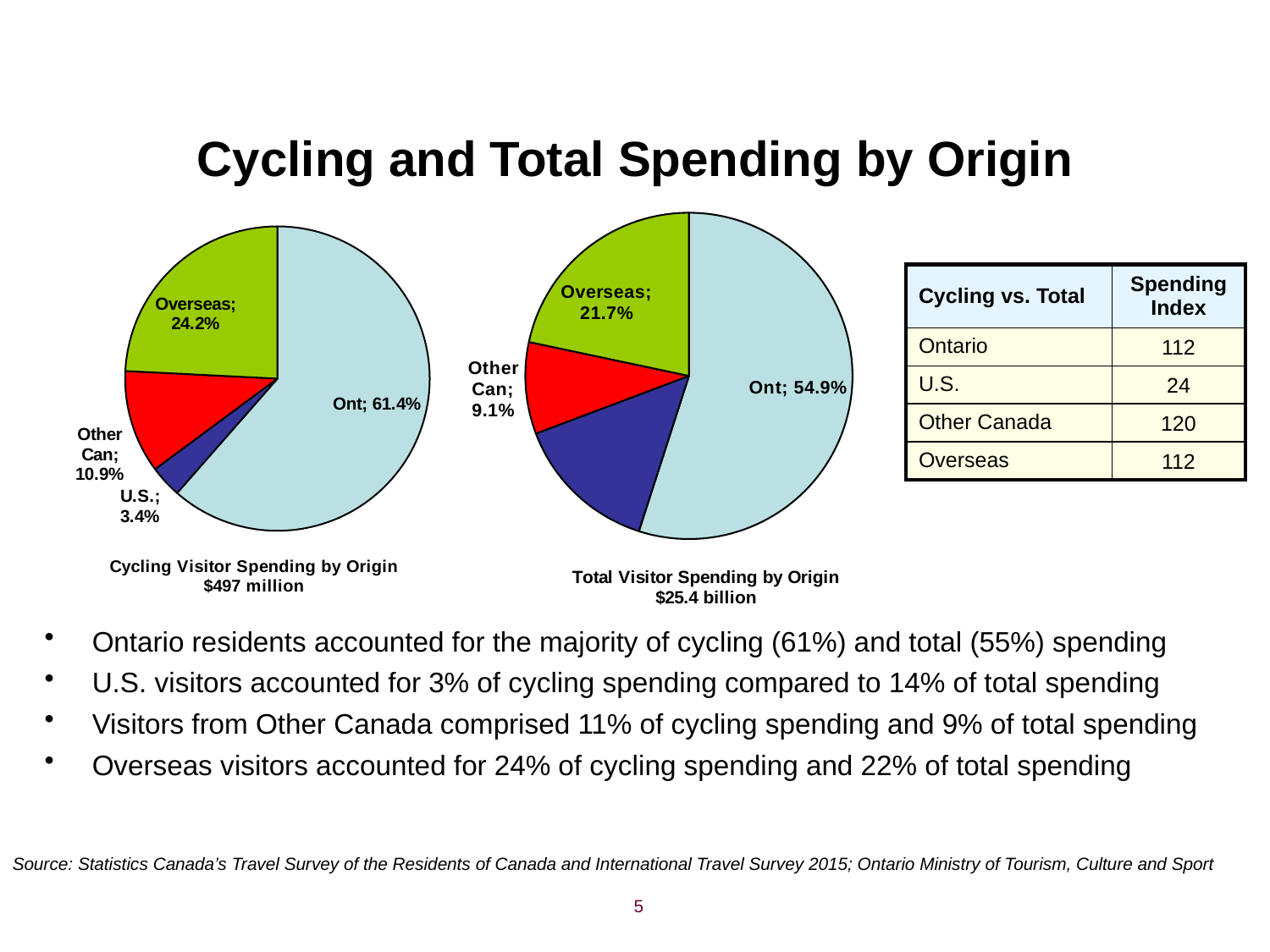
In the Total Visitor Spending by Origin pie chart, what share does Ontario account for? 54.9% In the Cycling Visitor Spending by Origin pie chart, what share does the U.S. account for? 3.4% What type of chart is used for Total Visitor Spending by Origin? Pie chart In the Cycling Visitor Spending by Origin pie chart, what share does Overseas account for? 24.2% Is the Ontario share larger in the Cycling Visitor Spending by Origin chart or in the Total Visitor Spending by Origin chart? Cycling Visitor Spending by Origin In the Cycling Visitor Spending by Origin pie chart, what share does Ontario account for? 61.4% What total amount is shown beneath the Cycling Visitor Spending by Origin pie chart? $497 million How many slices does the Cycling Visitor Spending by Origin pie chart have? 4 In the Cycling Visitor Spending by Origin pie chart, which origin has the smallest share? U.S. In the Total Visitor Spending by Origin pie chart, what share does Other Canada account for? 9.1% In the Cycling Visitor Spending by Origin pie chart, what is the difference between the Overseas share and the Other Can share? 13.3% In the Total Visitor Spending by Origin pie chart, which origin has the largest share? Ont